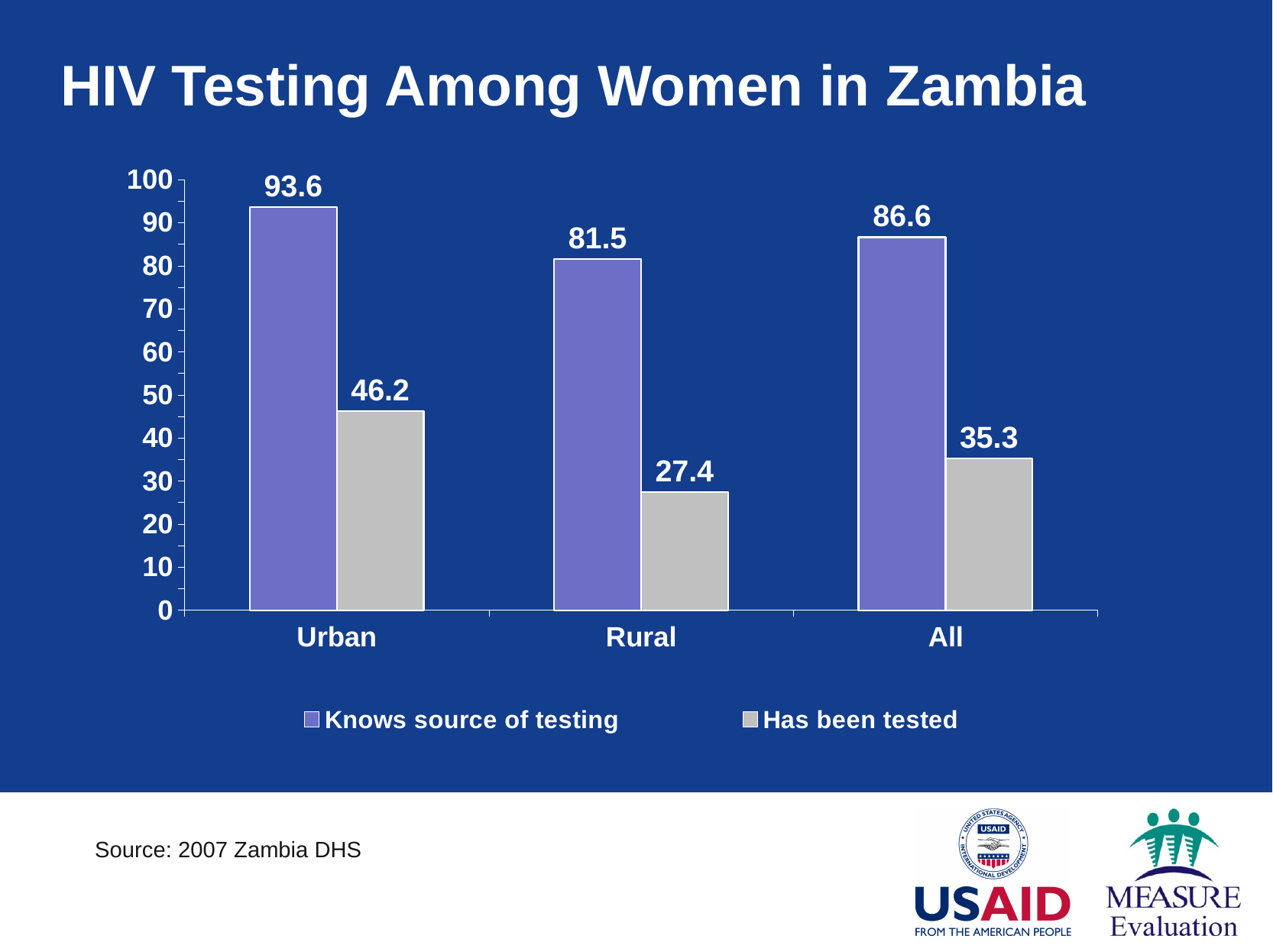
What is the value for 'Has been tested' in the All category? 35.3 Which is larger: 'Has been tested' for Urban or 'Has been tested' for All? Urban Is the value for 'Knows source of testing' in the Rural category greater or less than 80? greater What is the difference between the 'Knows source of testing' values for Urban and Rural? 12.1 How many categories are shown on the x axis? 3 What is the value for 'Knows source of testing' in the Urban category? 93.6 What is the difference between 'Knows source of testing' and 'Has been tested' in the Urban category? 47.4 Which category has the lowest value for 'Has been tested'? Rural What kind of chart is shown on the slide? Bar chart How many series does the legend list? 2 What is the value for 'Has been tested' in the Rural category? 27.4 Which category has the highest value for 'Knows source of testing'? Urban